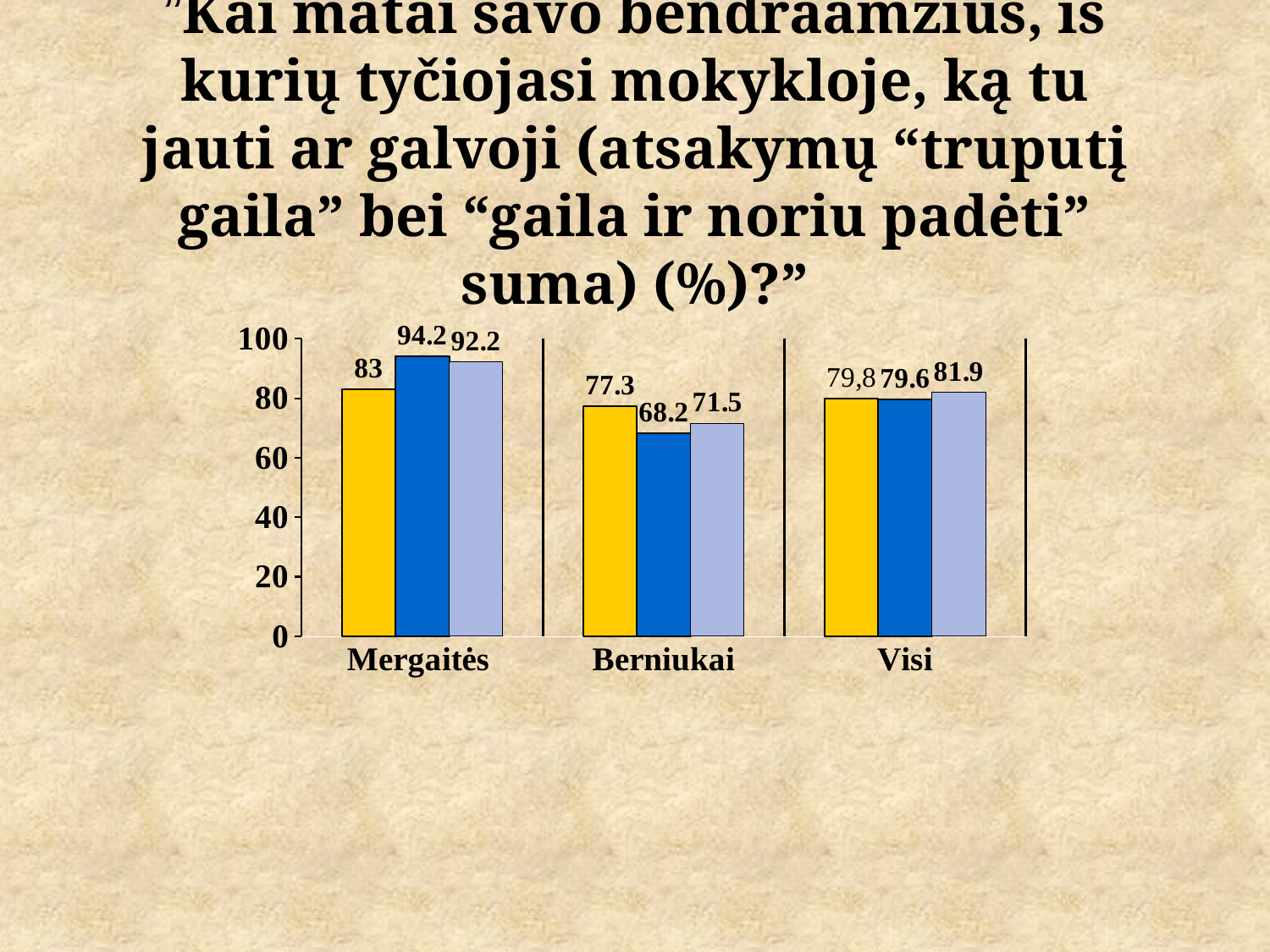
How many bars are shown for each category? 3 What is the difference between the dark blue bar for Mergaitės and the dark blue bar for Berniukai? 26 What is the value of the light blue bar for Mergaitės? 92.2 Is the value of the dark blue bar for Berniukai greater or less than 80? less What is the value of the yellow bar for Mergaitės? 83 Which category has the highest dark blue bar? Mergaitės What is the value of the light blue bar for Visi? 81.9 How many categories are shown on the x axis? 3 What type of chart is shown on the slide? bar chart Which is larger: the yellow bar for Berniukai or the light blue bar for Berniukai? the yellow bar for Berniukai Which category has the lowest light blue bar? Berniukai What is the value of the dark blue bar for Berniukai? 68.2